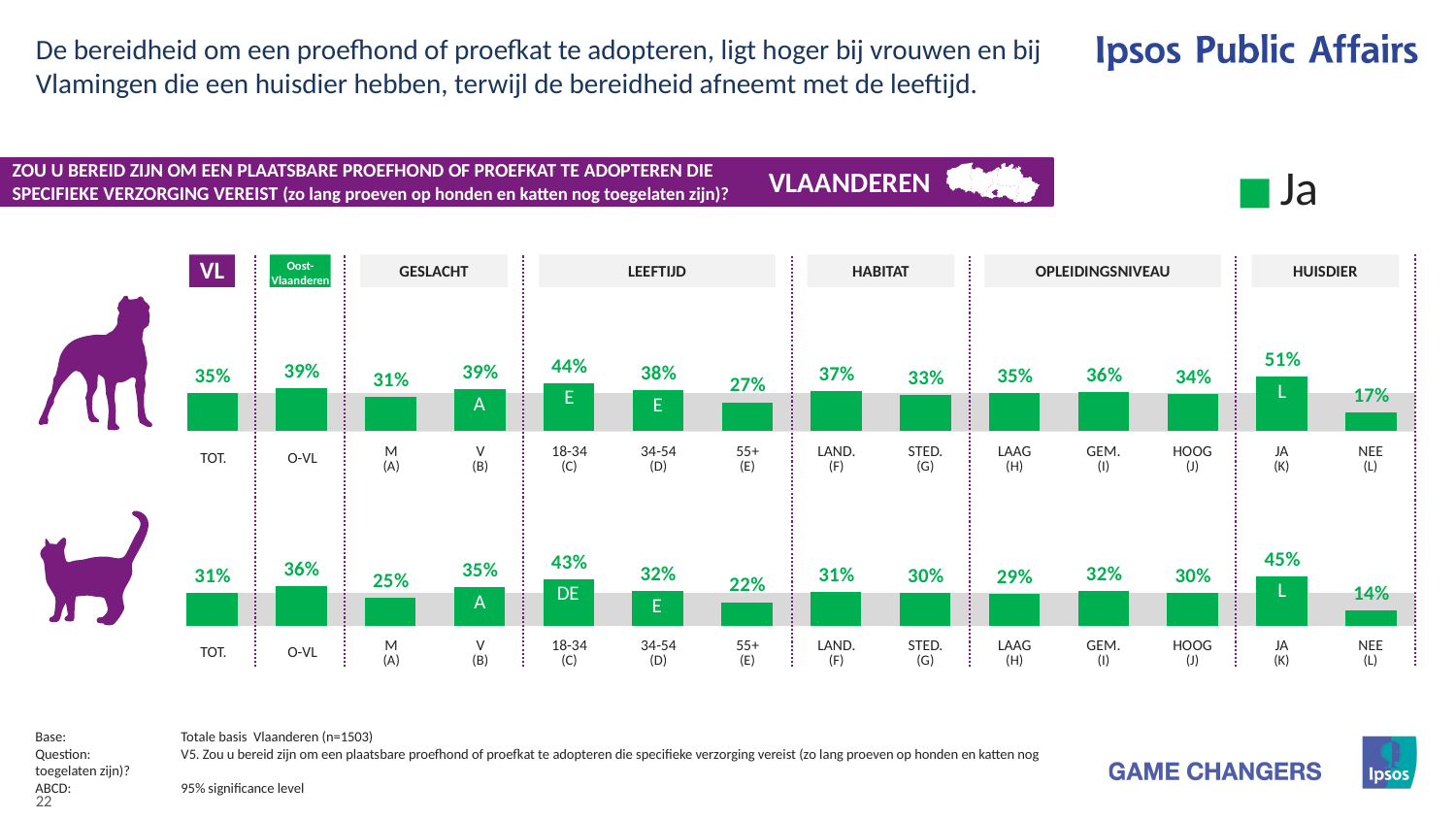
How many bars are shown in the top (dog) chart? 14 What is the single legend entry shown on the slide? Ja In the bottom (cat) chart, which category has the lowest value? NEE (L) In the bottom (cat) chart, what is the difference between the values for JA (K) and NEE (L)? 31% In the top (dog) chart, what is the difference between the values for V (B) and M (A)? 8% In the top (dog) chart, which category has the highest value? JA (K) In the bottom (cat) chart, which is larger: the value for 18-34 (C) or the value for 34-54 (D)? 18-34 (C) In the bottom (cat) chart, what is the value for the 55+ age group? 22% What kind of chart is used on this slide? Bar chart In the top (dog) chart, do the values rise or fall across the age groups from 18-34 to 55+? Fall In the top (dog) chart, what is the value for TOT.? 35% In the top (dog) chart, what is the value for O-VL? 39%